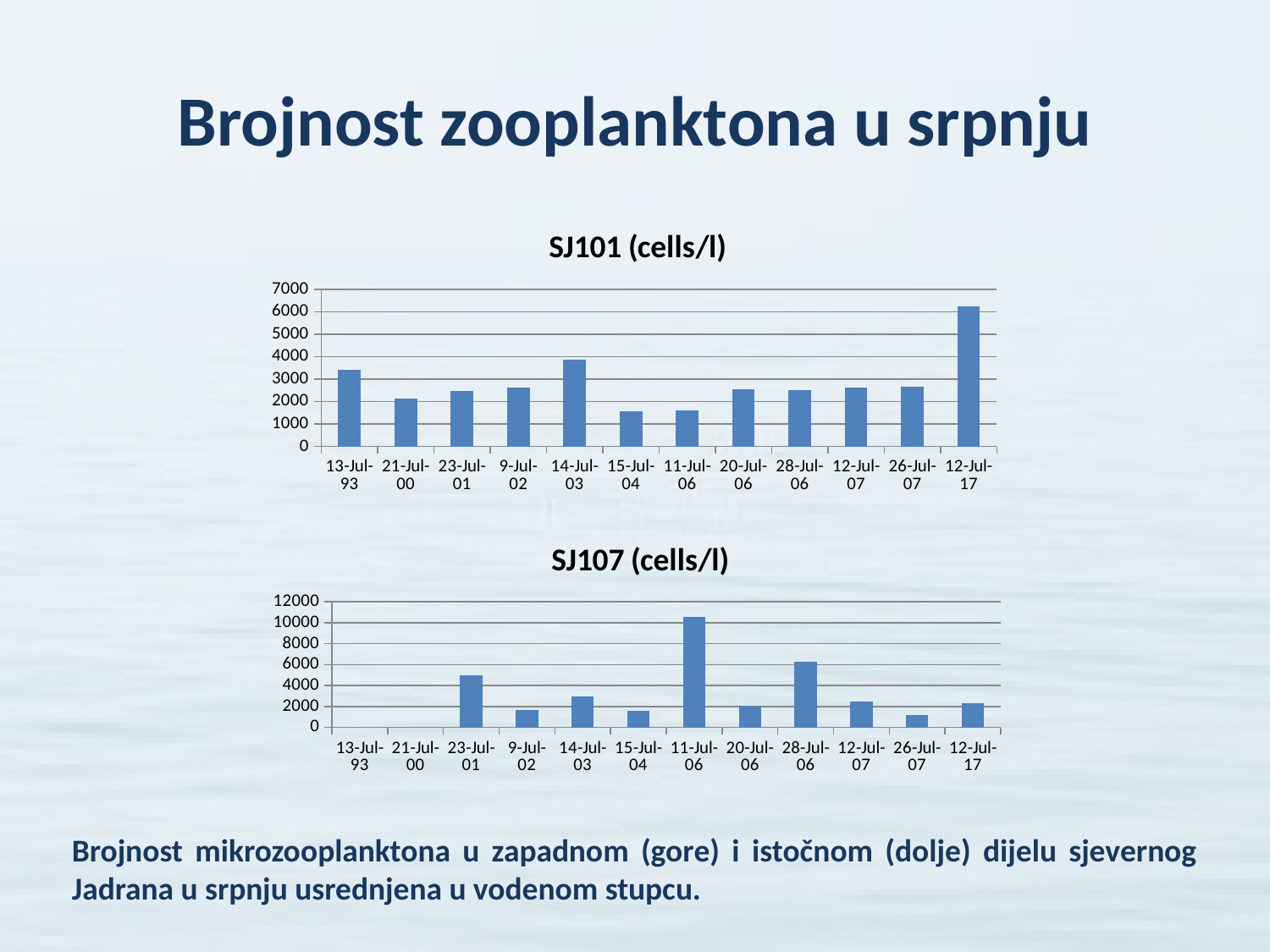
How many dates are shown on the x axis of the SJ101 (cells/l) chart? 12 In the SJ107 (cells/l) chart, which date has the highest value? 11-Jul-06 In the SJ107 (cells/l) chart, is the value for 11-Jul-06 greater or less than 10000? greater In the SJ101 (cells/l) chart, is the value for 15-Jul-04 greater or less than 2000? less What is the highest value shown on the y axis of the SJ107 (cells/l) chart? 12000 In the SJ107 (cells/l) chart, is the value for 26-Jul-07 greater or less than 2000? less In the SJ101 (cells/l) chart, which is larger, the value for 13-Jul-93 or the value for 21-Jul-00? 13-Jul-93 In the SJ101 (cells/l) chart, which date has the highest value? 12-Jul-17 What kind of chart is the SJ101 (cells/l) chart at the top of the slide? bar chart In the SJ107 (cells/l) chart, which is larger, the value for 28-Jul-06 or the value for 23-Jul-01? 28-Jul-06